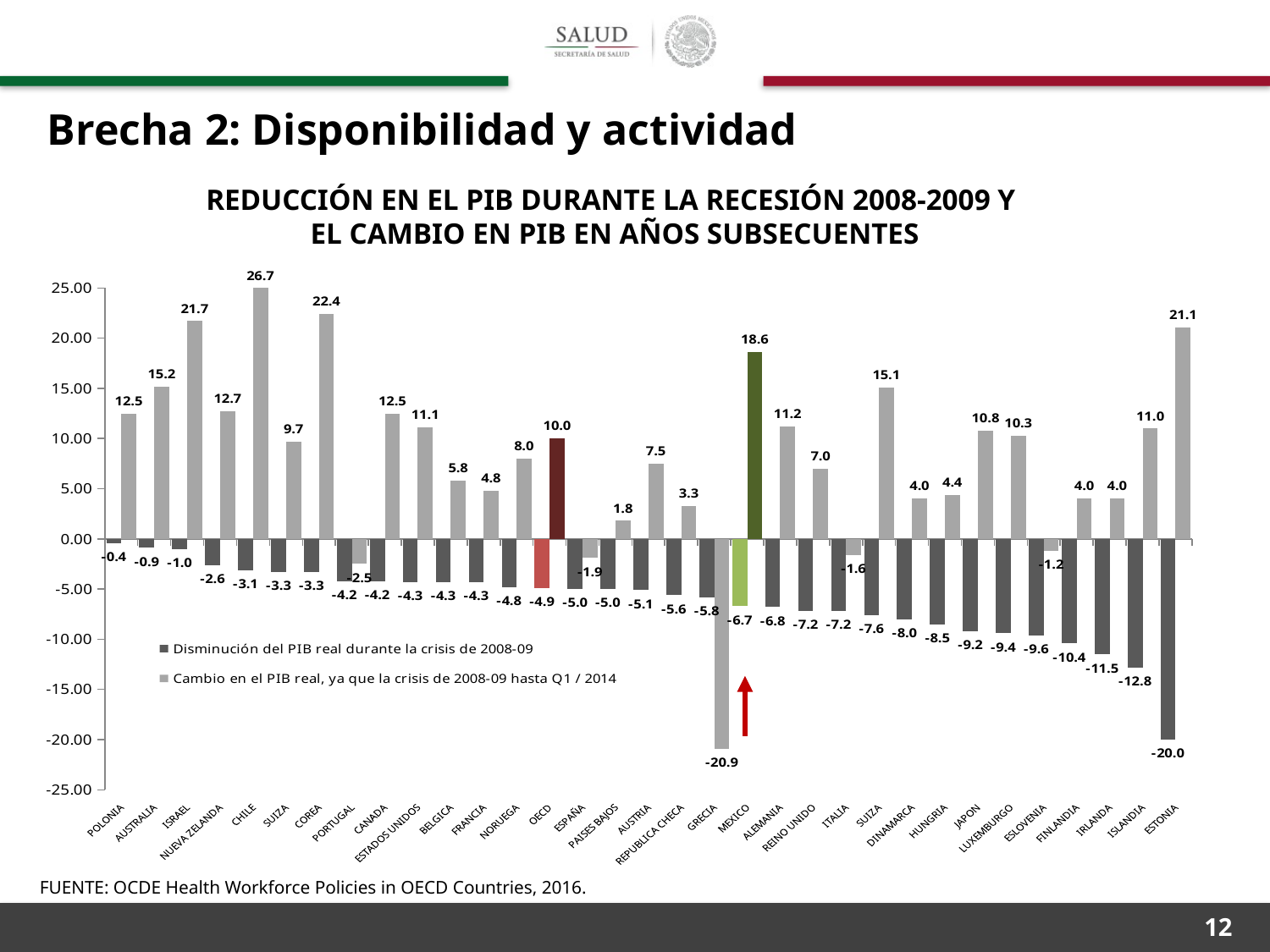
Which country has the highest value for 'Cambio en el PIB real, ya que la crisis de 2008-09 hasta Q1 / 2014'? CHILE What is the value of 'Cambio en el PIB real, ya que la crisis de 2008-09 hasta Q1 / 2014' for GRECIA? -20.9 What kind of chart is shown on the slide? Bar chart What colour is the 'Cambio en el PIB real' bar for MEXICO? Green What is the difference between the 'Disminución del PIB real durante la crisis de 2008-09' values for POLONIA and ESTONIA? 19.6 What is the difference between the 'Cambio en el PIB real' values for CHILE and COREA? 4.3 What is the value of 'Cambio en el PIB real, ya que la crisis de 2008-09 hasta Q1 / 2014' for MEXICO? 18.6 Which has the larger 'Cambio en el PIB real, ya que la crisis de 2008-09 hasta Q1 / 2014' value, MEXICO or ALEMANIA? MEXICO How many series does the legend list? 2 Which country has the lowest value for 'Disminución del PIB real durante la crisis de 2008-09'? ESTONIA What is the value of 'Disminución del PIB real durante la crisis de 2008-09' for OECD? -4.9 How many countries/categories are shown on the x axis of the chart? 33